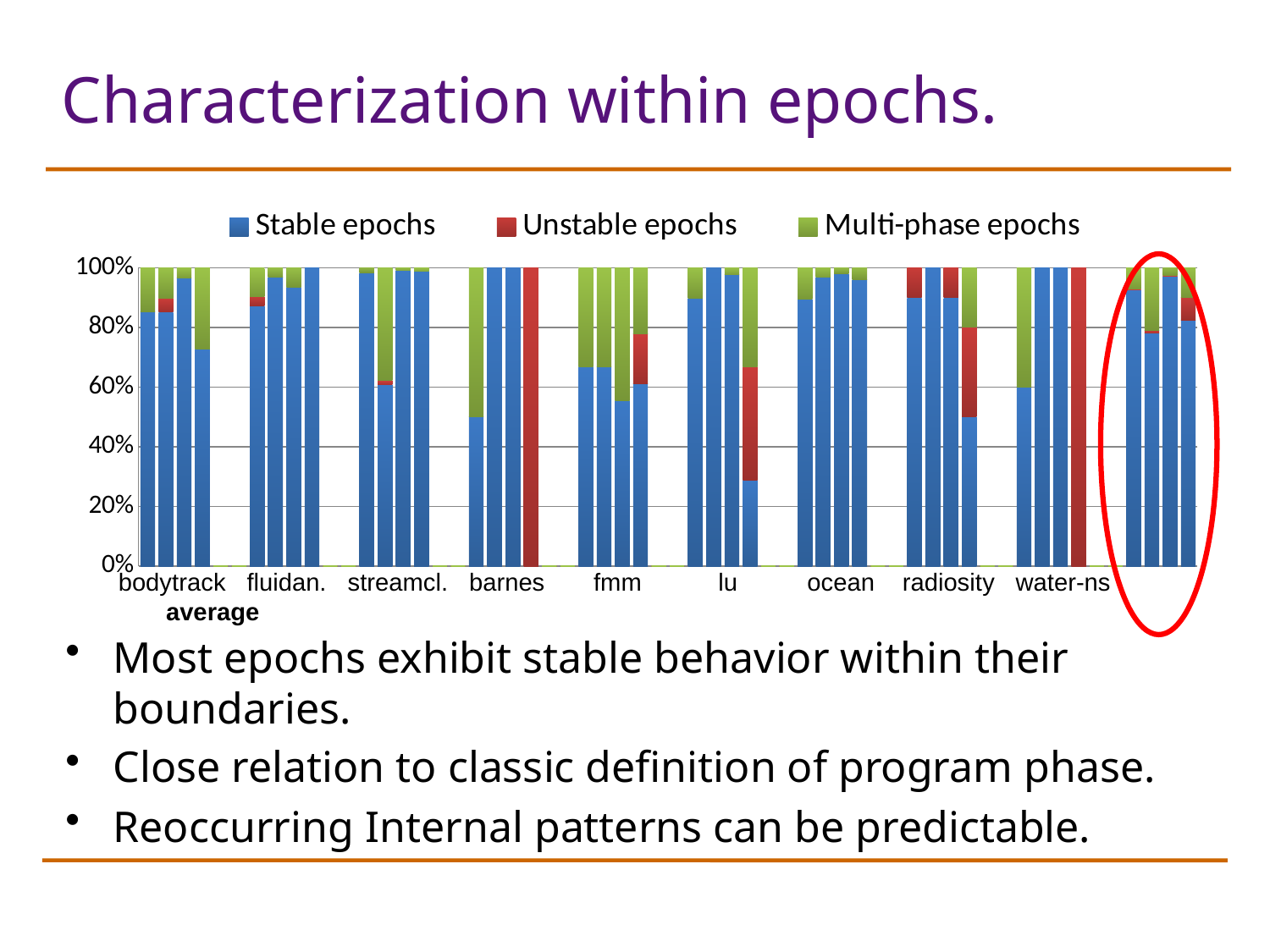
What are the three series named in the legend? Stable epochs, Unstable epochs, Multi-phase epochs What kind of chart is shown on the slide? Stacked bar chart Is the Stable epochs value for the last bar in the barnes group greater or less than 20%? less How many benchmark groups are labeled along the x axis, including average? 10 Which colour represents Unstable epochs in the chart? Red Is the Stable epochs value for the first bar in the bodytrack group greater or less than 80%? greater Which x-axis group is highlighted with a red ellipse? average How many series does the legend list? 3 Is the Stable epochs value for the first bar in the barnes group greater or less than 60%? less What is the total height of each stacked bar in the chart? 100%